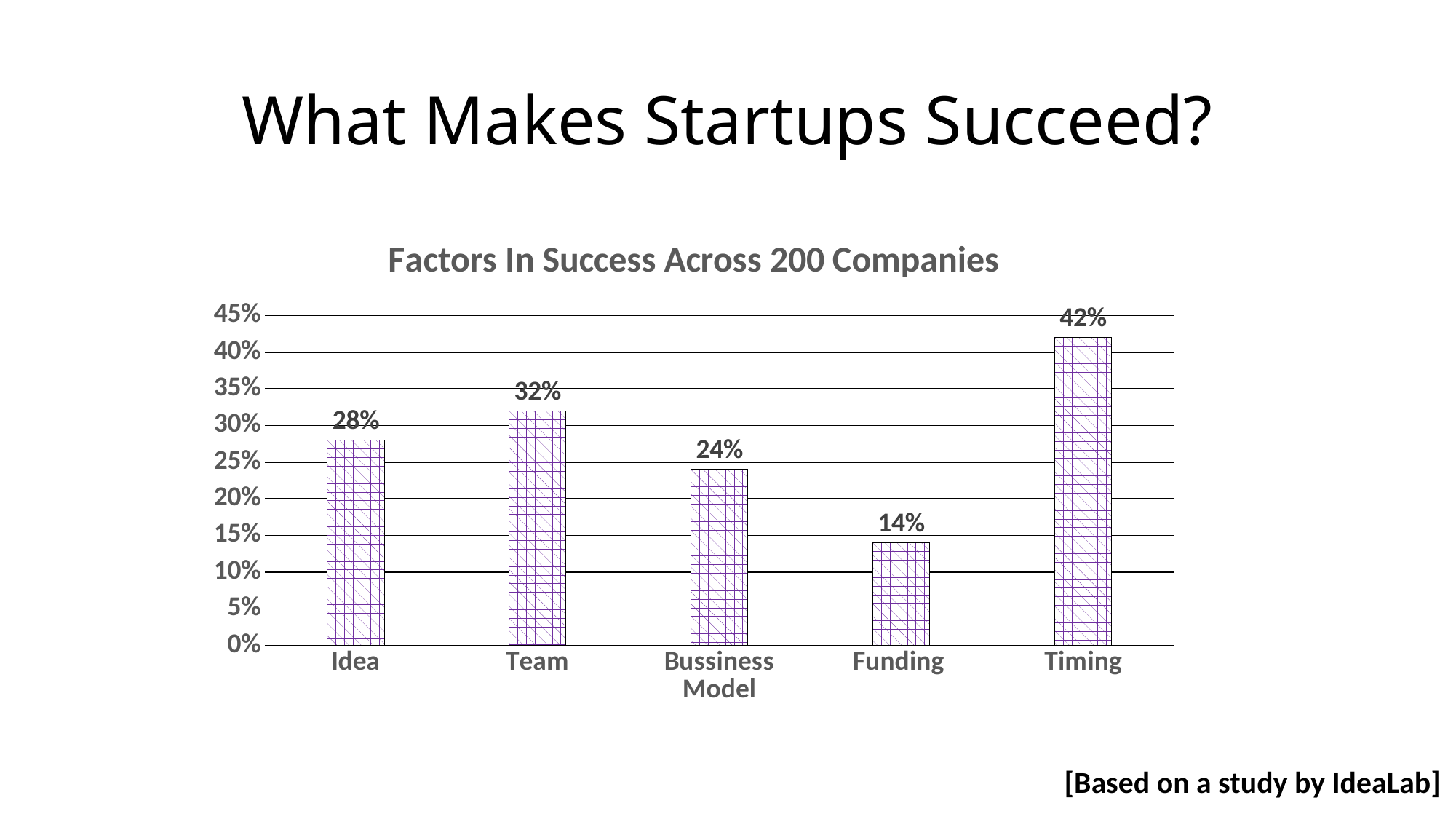
What is the value for Funding? 14% How many categories are shown on the x axis? 5 Which category has the highest value? Timing Which is larger, the value for Idea or the value for Bussiness Model? Idea What is the value for Bussiness Model? 24% What is the difference between the values for Timing and Funding? 28% What kind of chart is shown on the slide? Bar chart Which category has the lowest value? Funding What is the title of the chart? Factors In Success Across 200 Companies Is the value for Team greater or less than 30%? greater What is the difference between the values for Team and Idea? 4% What is the value for Timing? 42%